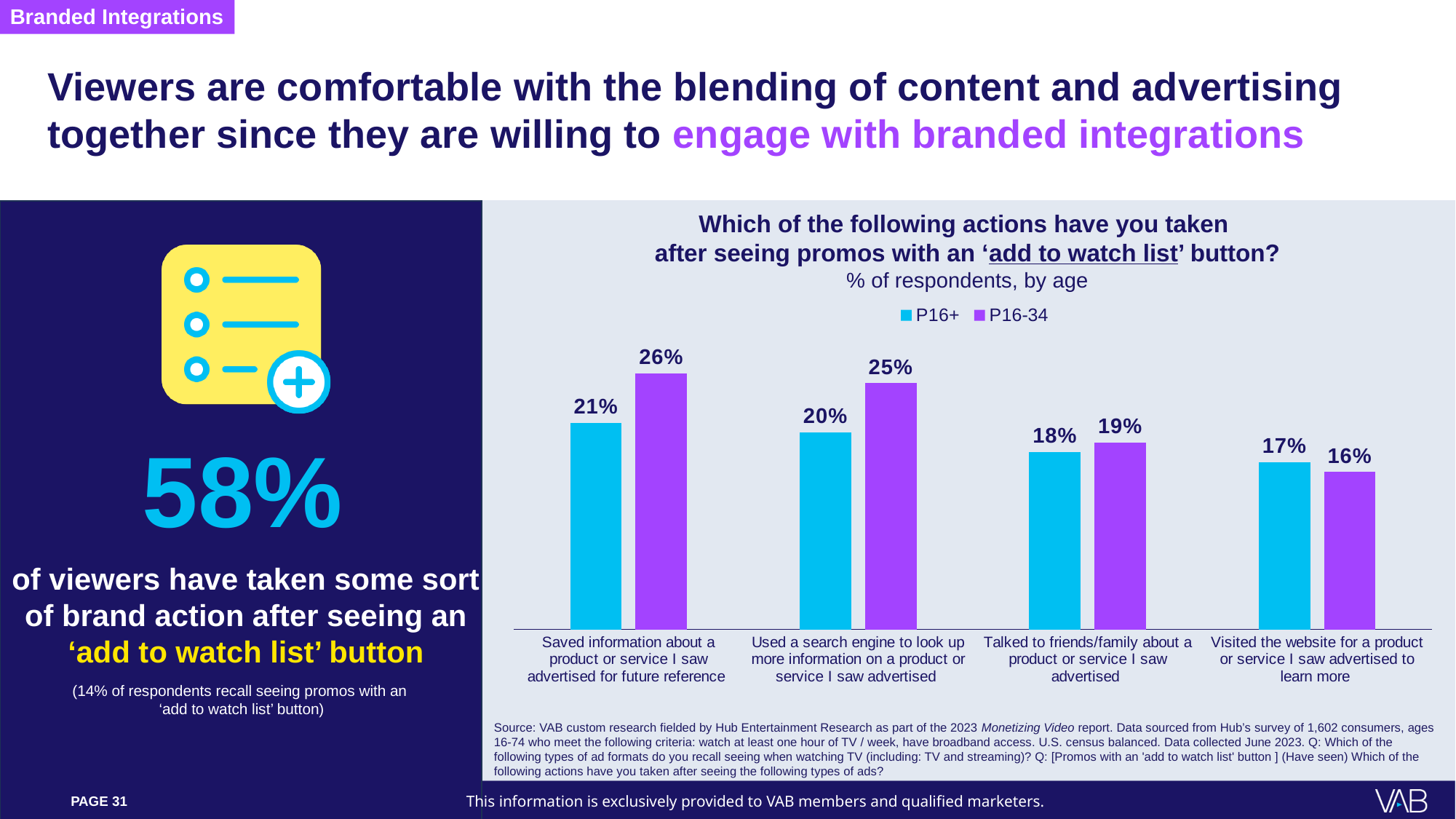
What percentage of P16-34 respondents used a search engine to look up more information on a product or service they saw advertised? 25% What is the difference between the P16-34 and P16+ values for 'Used a search engine to look up more information on a product or service I saw advertised'? 5% What is the P16+ value for 'Visited the website for a product or service I saw advertised to learn more'? 17% Which action has the highest value for the P16-34 series? Saved information about a product or service I saw advertised for future reference How many action categories are shown on the x axis of the chart? 4 Which colour represents the P16-34 series in the chart? Purple How many series does the chart legend list? 2 For 'Visited the website for a product or service I saw advertised to learn more', which series has the larger value, P16+ or P16-34? P16+ What type of chart is used to show the actions taken after seeing promos with an 'add to watch list' button? Bar chart For 'Talked to friends/family about a product or service I saw advertised', which series has the larger value, P16+ or P16-34? P16-34 What percentage of P16+ respondents saved information about a product or service they saw advertised for future reference? 21% Which action has the lowest value for the P16+ series? Visited the website for a product or service I saw advertised to learn more